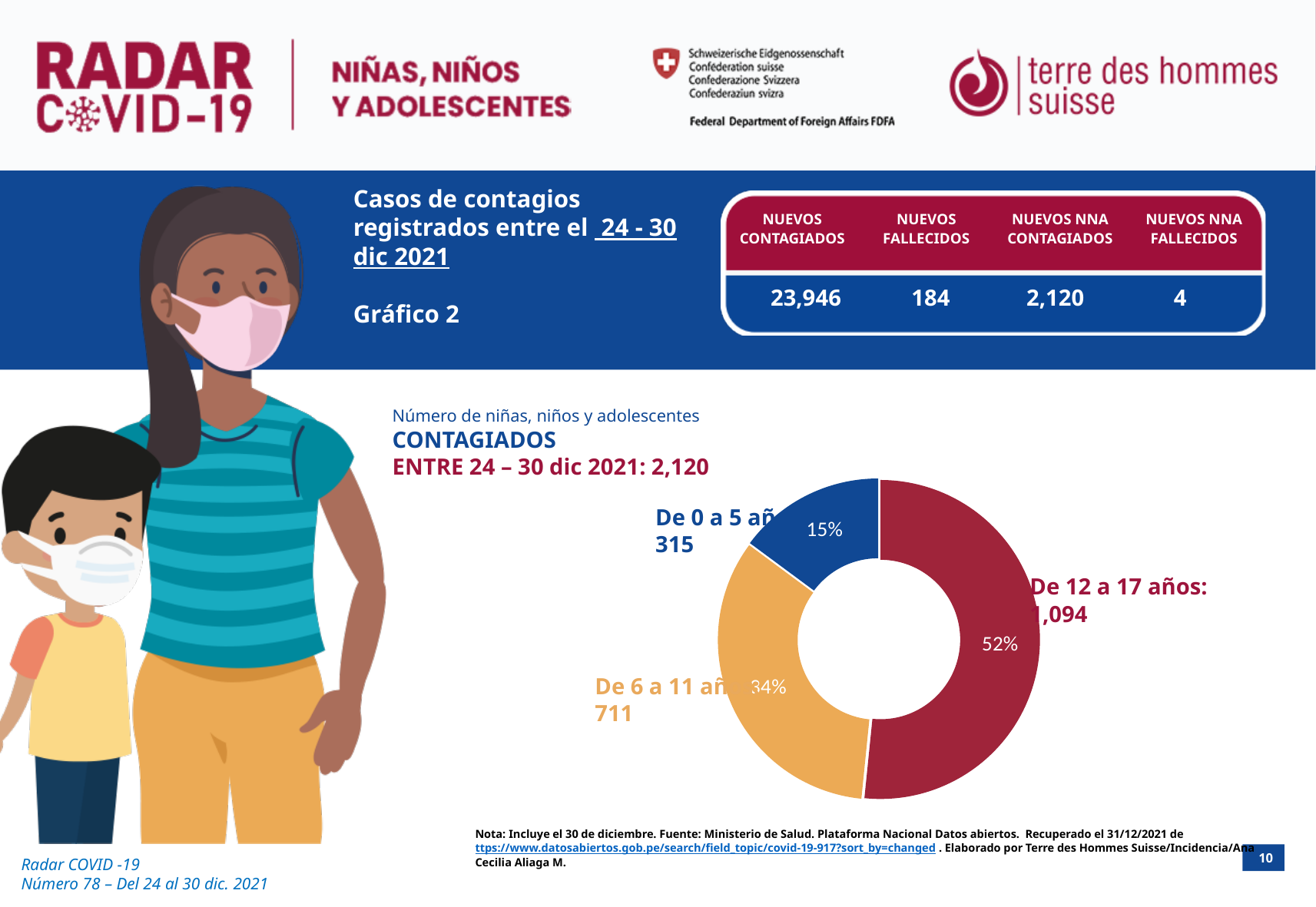
What percentage share of the donut chart does the group De 0 a 5 años represent? 15% Which group has more contagiados, De 6 a 11 años or De 0 a 5 años? De 6 a 11 años What total number of contagiados is stated in the chart heading for 24 – 30 dic 2021? 2,120 What is the number of contagiados for the group De 12 a 17 años? 1,094 What is the number of contagiados for the group De 0 a 5 años? 315 How many age groups does the donut chart show? 3 Which age group has the lowest number of contagiados? De 0 a 5 años What is the difference in contagiados between De 12 a 17 años and De 6 a 11 años? 383 What percentage share of the donut chart does the group De 12 a 17 años represent? 52% What kind of chart is shown on the slide? Donut (pie) chart What is the number of contagiados for the group De 6 a 11 años? 711 Which age group has the highest number of contagiados? De 12 a 17 años